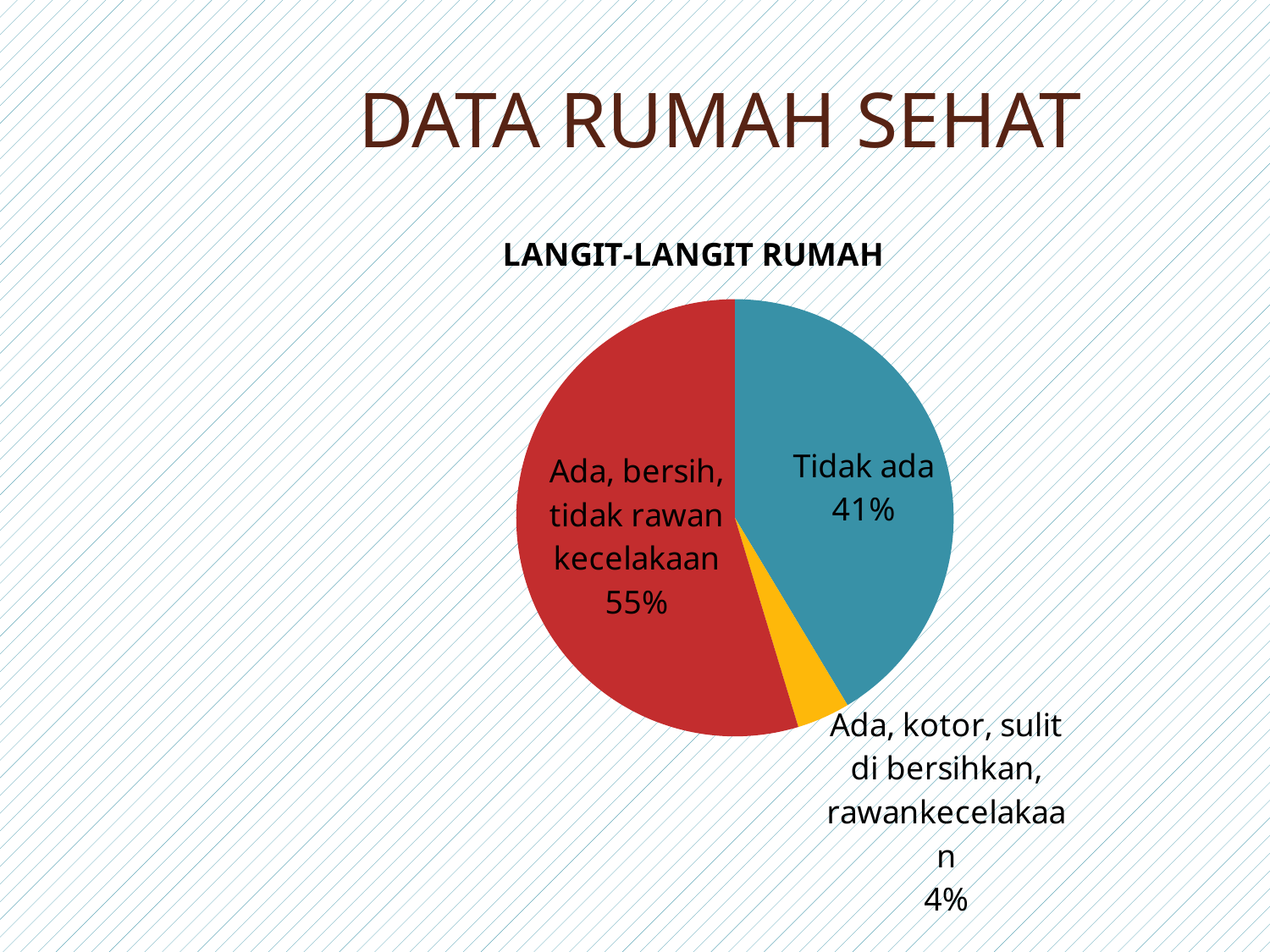
Which is larger: the share for "Tidak ada" or the share for "Ada, bersih, tidak rawan kecelakaan"? Ada, bersih, tidak rawan kecelakaan What kind of chart is shown on the slide? pie chart What share of the pie is labelled "Tidak ada"? 41% What share of the pie is labelled "Ada, kotor, sulit di bersihkan, rawankecelakaan"? 4% What share of the pie is labelled "Ada, bersih, tidak rawan kecelakaan"? 55% What is the difference in percentage points between "Tidak ada" and "Ada, kotor, sulit di bersihkan, rawankecelakaan"? 37 What colour is the slice for "Tidak ada"? blue Which category has the largest slice of the pie? Ada, bersih, tidak rawan kecelakaan Which category has the smallest slice of the pie? Ada, kotor, sulit di bersihkan, rawankecelakaan What is the title of the chart? LANGIT-LANGIT RUMAH What is the difference in percentage points between "Ada, bersih, tidak rawan kecelakaan" and "Tidak ada"? 14 How many slices does the pie chart have? 3